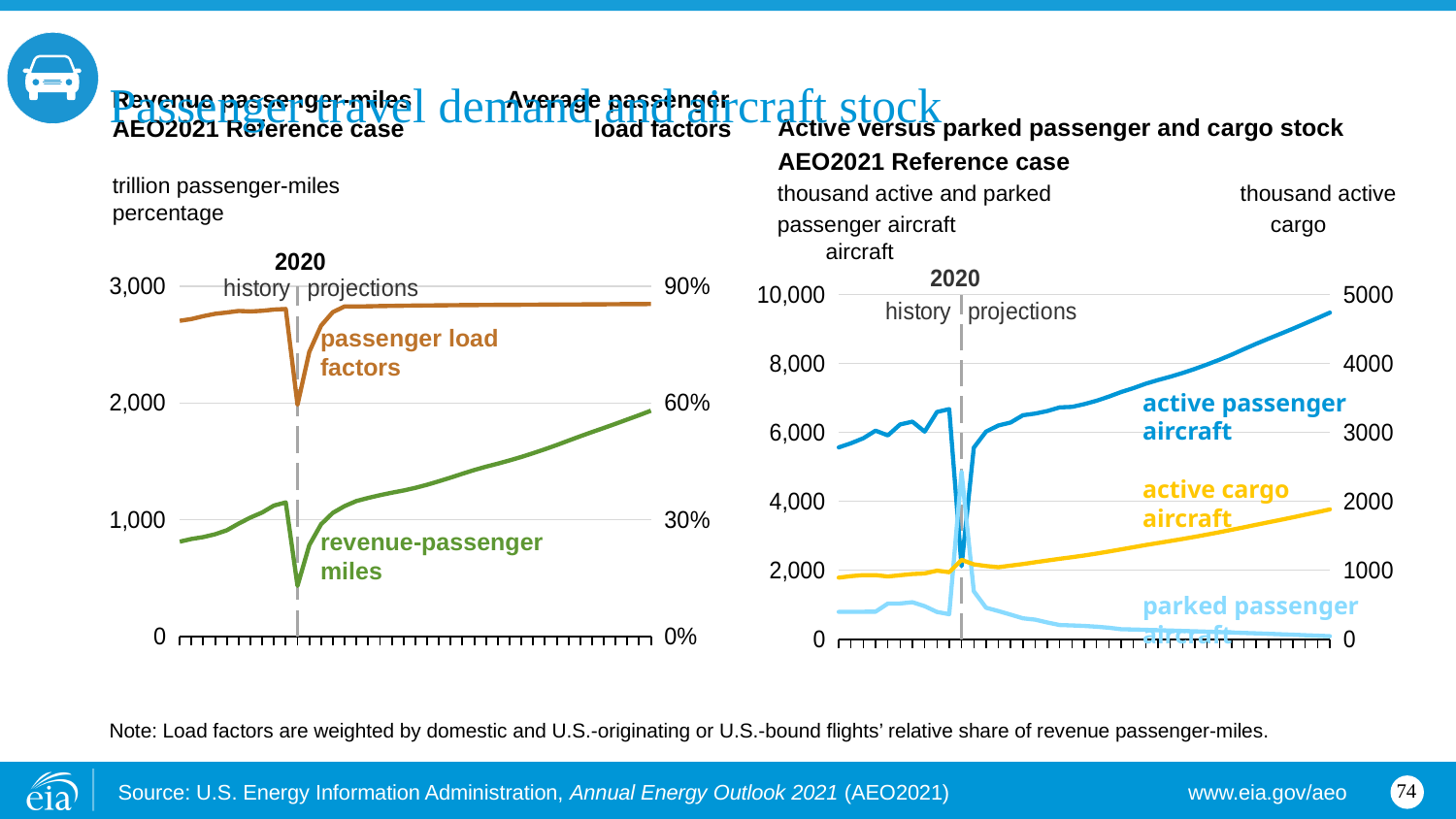
How many data series are labeled on the right chart, 'Active versus parked passenger and cargo stock'? 3 What year does the dashed vertical line separating history from projections mark on both charts? 2020 What kind of chart is the right chart, 'Active versus parked passenger and cargo stock'? line chart In the right chart, is the value for active passenger aircraft at the end of the projection period greater or less than 8,000? greater How many data series are labeled on the left chart, 'Revenue passenger-miles / Average passenger load factors'? 2 In the left chart, is the value for revenue-passenger miles at the end of the projection period greater or less than 1,000? greater What kind of chart is the left chart, 'Revenue passenger-miles / Average passenger load factors'? line chart In the left chart, is the passenger load factor at the end of the projection period greater or less than 60%? greater In the left chart, do revenue-passenger miles rise or fall over the projection period after 2020? rise In the right chart, do active passenger aircraft rise or fall over the projection period after 2020? rise In the right chart, do parked passenger aircraft rise or fall over the projection period after 2020? fall In the right chart, which series is labeled in yellow? active cargo aircraft